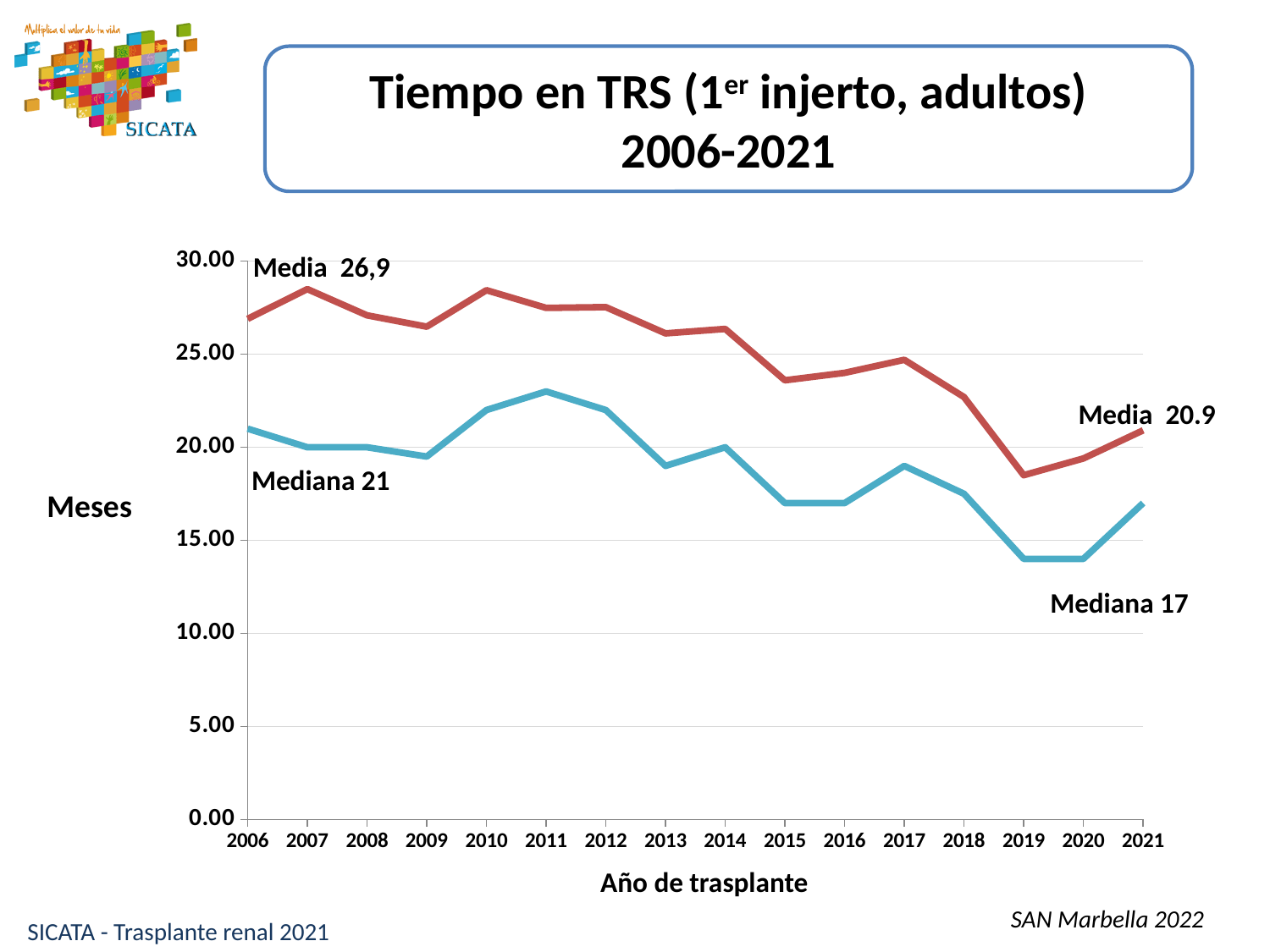
What is the labelled value of the Media series in 2021? 20.9 Is the Media value for 2007 greater or less than 25.00? greater In 2021, which series has the larger value, Media or Mediana? Media What is the labelled value of the Mediana series in 2006? 21 How many transplant years are plotted along the x axis? 16 By how much did the Mediana value fall from 2006 to 2021? 4 What is the labelled value of the Mediana series in 2021? 17 What is the labelled value of the Media series in 2006? 26,9 By how much did the Media value fall from 2006 to 2021? 6 What kind of chart is shown on the slide? line chart Is the Mediana value for 2019 greater or less than 15.00? less What is the label on the vertical axis of the chart? Meses